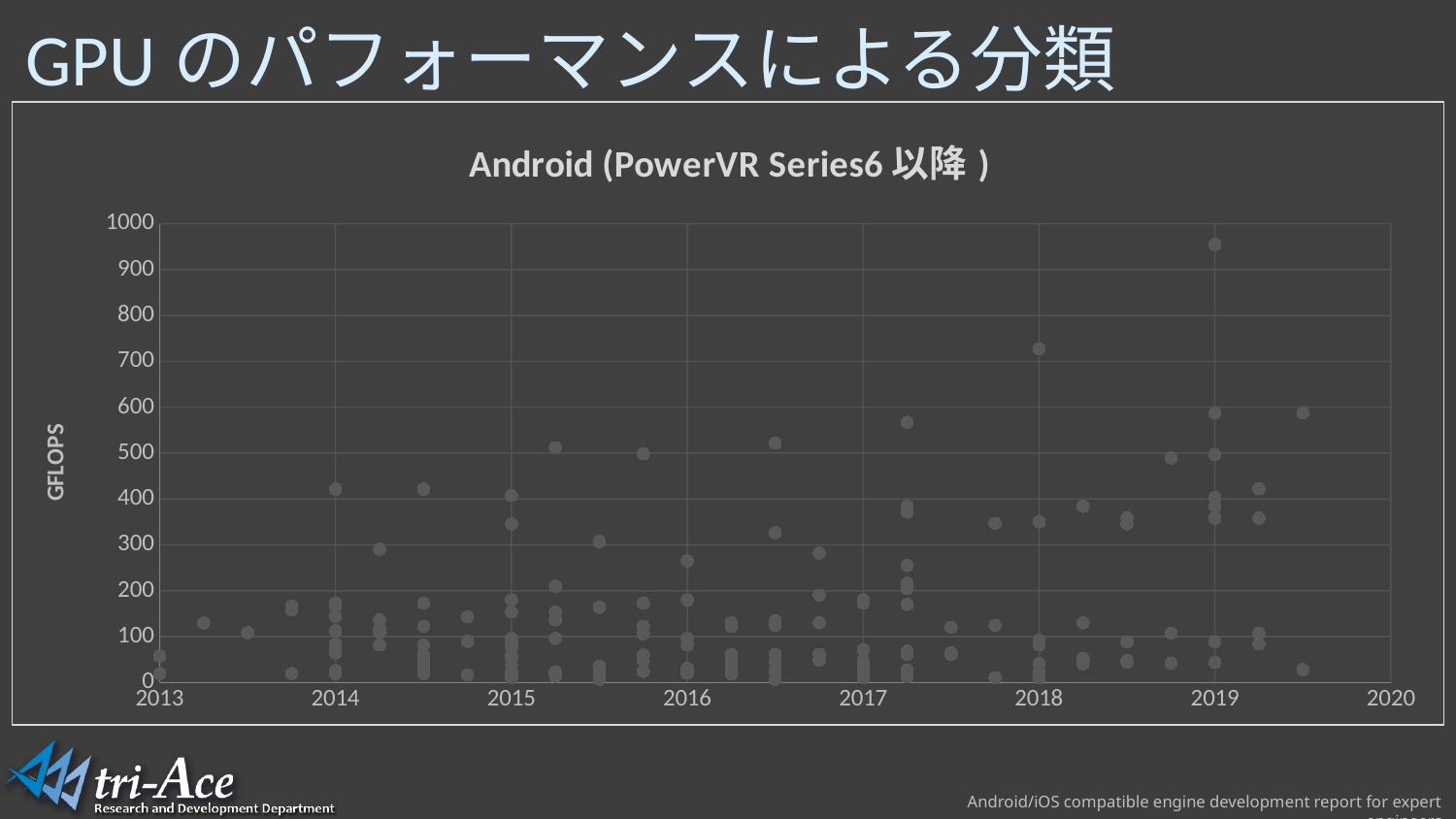
What is the label on the vertical axis of the chart? GFLOPS Around which year does the highest plotted GFLOPS value appear? 2019 What is the last year shown on the horizontal axis? 2020 Is the highest plotted point (near 2019) greater or less than 900 GFLOPS? greater What is the interval between consecutive tick marks on the vertical axis? 100 What is the first year shown on the horizontal axis? 2013 What is the title of the chart? Android (PowerVR Series6 以降 ) What kind of chart is shown on the slide? scatter chart Do the maximum plotted GFLOPS values generally rise or fall from 2013 to 2019? rise Is the highest plotted point near 2018 greater or less than 600 GFLOPS? greater What is the highest value shown on the vertical axis? 1000 Is the highest plotted point at 2013 greater or less than 200 GFLOPS? less